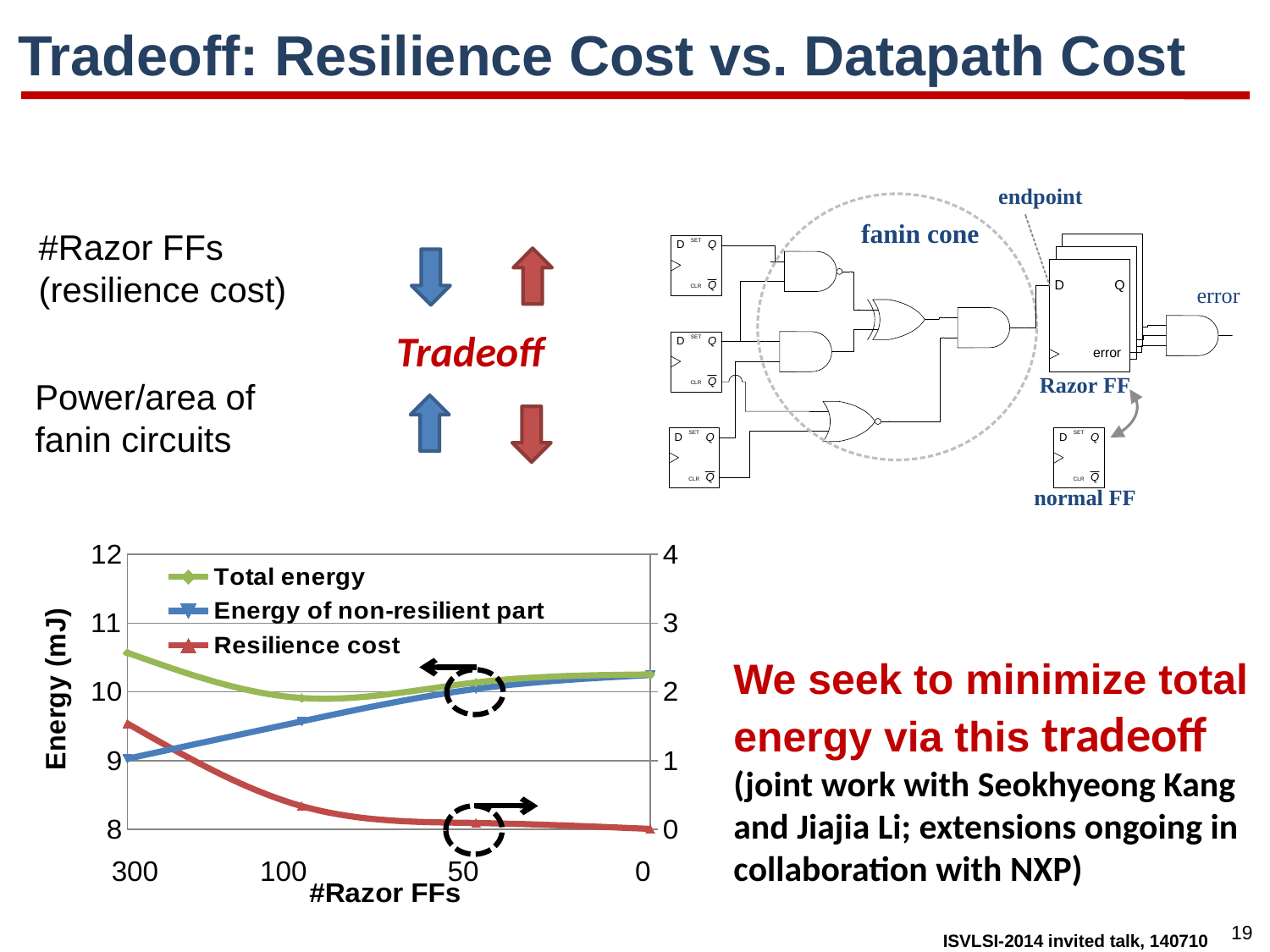
At which x-axis value does the Total energy series reach its lowest point? 100 Does the Resilience cost series rise or fall moving from left to right along the x axis? fall What kind of chart is shown on the slide? line chart What is the title of the chart's left vertical axis? Energy (mJ) Is the Total energy value at 300 Razor FFs greater or less than 10? greater Is the Energy of non-resilient part value at 0 Razor FFs greater or less than 10? greater At 300 Razor FFs, which is larger: Total energy or Energy of non-resilient part? Total energy Is the Resilience cost value at 300 Razor FFs greater or less than 1 on the right-hand axis? greater Does the Energy of non-resilient part series rise or fall moving from left to right along the x axis? rise What is the title of the chart's horizontal axis? #Razor FFs How many series does the chart's legend list? 3